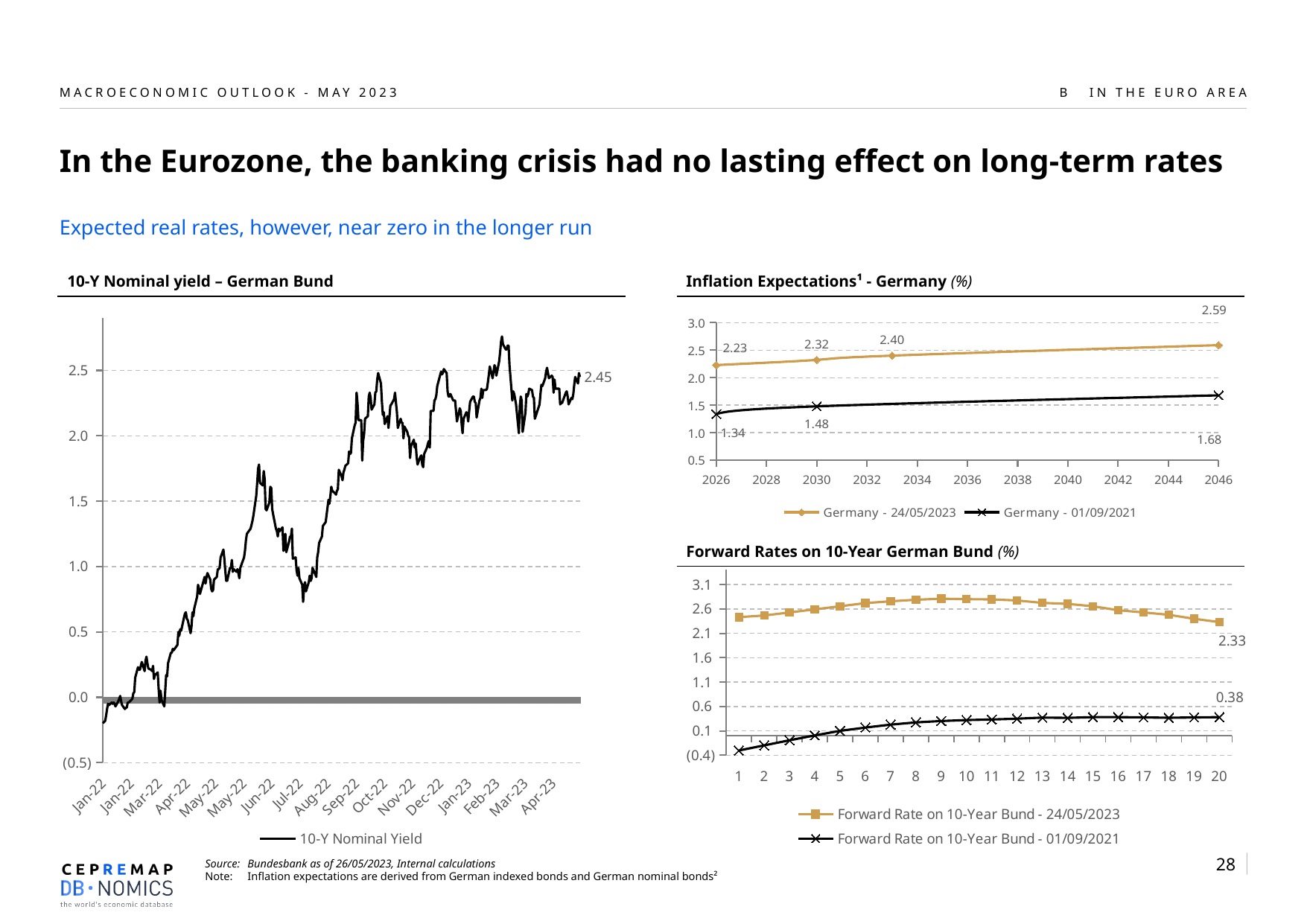
On the 'Inflation Expectations - Germany' chart, what is the value for Germany - 01/09/2021 in 2030? 1.48 How many series does the legend of the 'Inflation Expectations - Germany' chart list? 2 On the 'Inflation Expectations - Germany' chart, what is the difference between the two series in 2046? 0.91 On the 'Inflation Expectations - Germany' chart, what is the value for Germany - 24/05/2023 in 2046? 2.59 On the 'Inflation Expectations - Germany' chart, which series is higher in 2046? Germany - 24/05/2023 On the 'Forward Rates on 10-Year German Bund' chart, is the value for Forward Rate on 10-Year Bund - 01/09/2021 at point 1 greater or less than 0.1? less On the 'Forward Rates on 10-Year German Bund' chart, what is the value for Forward Rate on 10-Year Bund - 24/05/2023 at point 20? 2.33 On the 'Inflation Expectations - Germany' chart, does the Germany - 24/05/2023 series rise or fall from 2026 to 2046? Rise How many points are on the x axis of the 'Forward Rates on 10-Year German Bund' chart? 20 On the 'Forward Rates on 10-Year German Bund' chart, what is the value for Forward Rate on 10-Year Bund - 01/09/2021 at point 20? 0.38 What kind of chart is 'Forward Rates on 10-Year German Bund'? Line chart On the '10-Y Nominal yield – German Bund' chart, what is the latest value labelled at the end of the line? 2.45